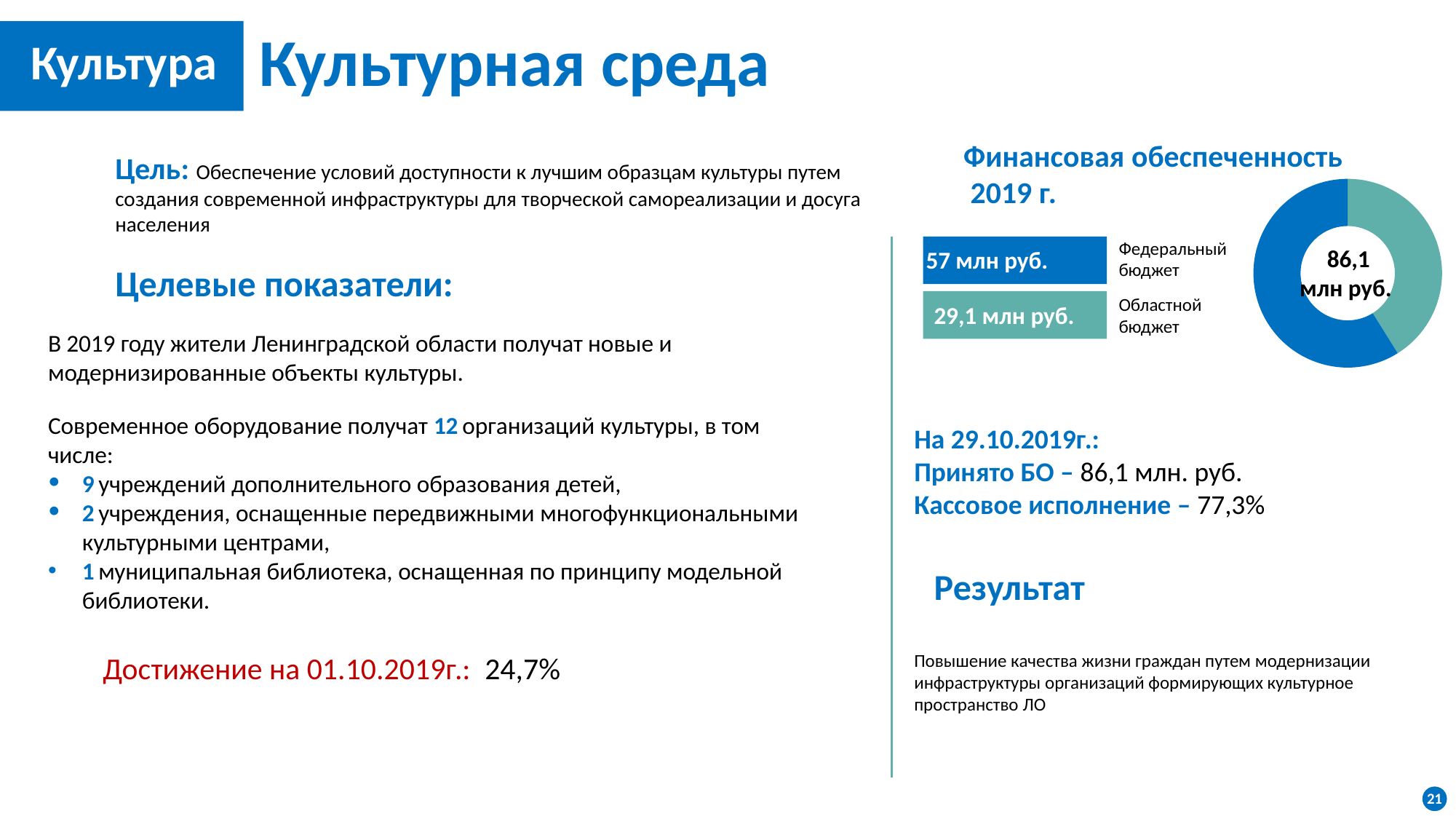
Which budget source has the smaller value in the "Финансовая обеспеченность 2019 г." chart? Областной бюджет In the "Финансовая обеспеченность 2019 г." chart, is Областной бюджет larger or smaller than Федеральный бюджет? smaller What is the value for Областной бюджет in the "Финансовая обеспеченность 2019 г." chart? 29,1 млн руб. In the "Финансовая обеспеченность 2019 г." chart, by how much does Федеральный бюджет exceed Областной бюджет? 27,9 млн руб. What total value is shown in the centre of the "Финансовая обеспеченность 2019 г." chart? 86,1 млн руб. What is the title of the chart on the right side of the slide? Финансовая обеспеченность 2019 г. What is the value for Федеральный бюджет in the "Финансовая обеспеченность 2019 г." chart? 57 млн руб. What kind of chart is shown under the title "Финансовая обеспеченность 2019 г."? doughnut (pie) chart Which budget source has the larger value in the "Финансовая обеспеченность 2019 г." chart? Федеральный бюджет How many segments does the "Финансовая обеспеченность 2019 г." chart have? 2 What colour represents Федеральный бюджет in the "Финансовая обеспеченность 2019 г." chart? blue What is the combined value of Федеральный бюджет and Областной бюджет in the "Финансовая обеспеченность 2019 г." chart? 86,1 млн руб.